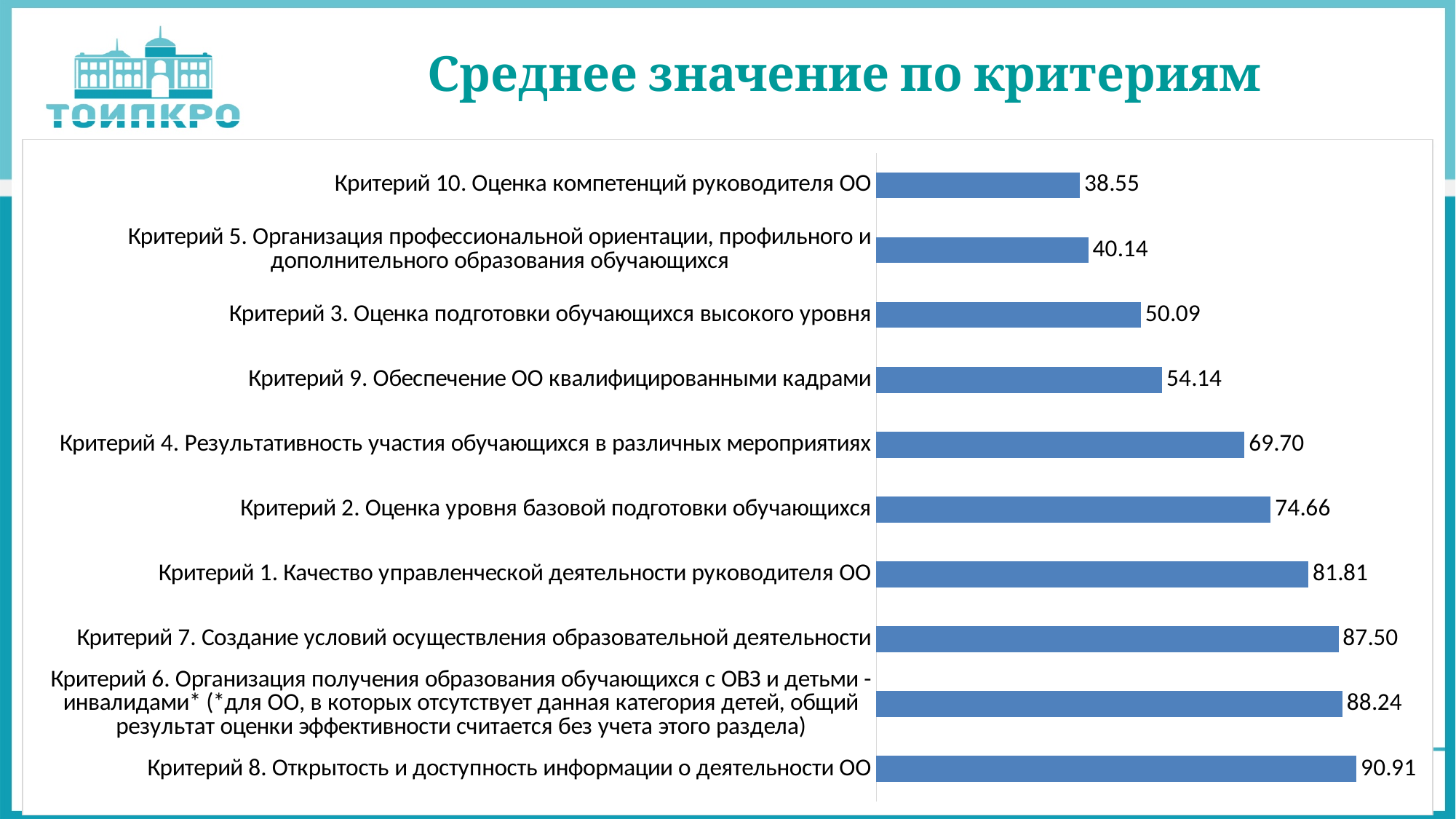
How many criteria are shown in the chart? 10 Which criterion has the lowest value? Критерий 10. Оценка компетенций руководителя ОО Which has a larger value, Критерий 1 or Критерий 2? Критерий 1 What is the value for Критерий 10 (Оценка компетенций руководителя ОО)? 38.55 What is the title of the slide? Среднее значение по критериям What is the difference between the values for Критерий 7 and Критерий 2? 12.84 What is the difference between the values for Критерий 8 and Критерий 10? 52.36 Which criterion has the highest value? Критерий 8. Открытость и доступность информации о деятельности ОО What is the value for Критерий 7 (Создание условий осуществления образовательной деятельности)? 87.50 What type of chart is shown on the slide? Bar chart What is the value for Критерий 8 (Открытость и доступность информации о деятельности ОО)? 90.91 What is the value for Критерий 4 (Результативность участия обучающихся в различных мероприятиях)? 69.70